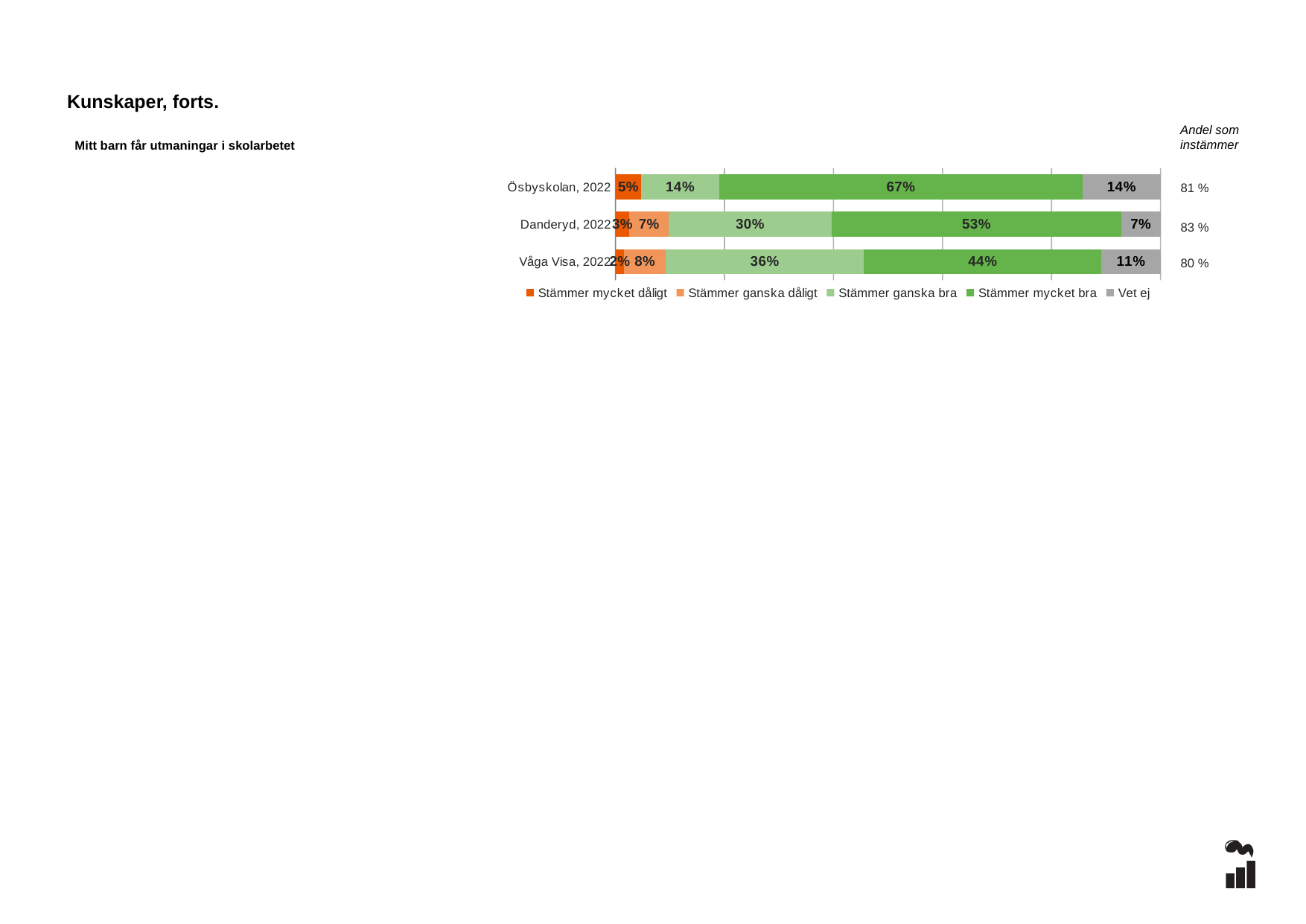
How many series does the legend list? 5 What kind of chart is shown on the slide? Stacked bar chart How many categories (bars) are shown in the chart? 3 What is the value of "Stämmer mycket dåligt" for Danderyd, 2022? 3% What is the difference between the "Stämmer mycket bra" values for Ösbyskolan, 2022 and Våga Visa, 2022? 23 percentage points What is the "Andel som instämmer" figure shown for Danderyd, 2022? 83 % Which is larger: the "Vet ej" value for Ösbyskolan, 2022 or for Danderyd, 2022? Ösbyskolan, 2022 Which category has the highest value for "Stämmer mycket bra"? Ösbyskolan, 2022 What is the value of "Vet ej" for Våga Visa, 2022? 11% What is the value of "Stämmer ganska bra" for Danderyd, 2022? 30% What is the value of "Stämmer mycket bra" for Ösbyskolan, 2022? 67% Which category has the lowest value for "Stämmer ganska bra"? Ösbyskolan, 2022